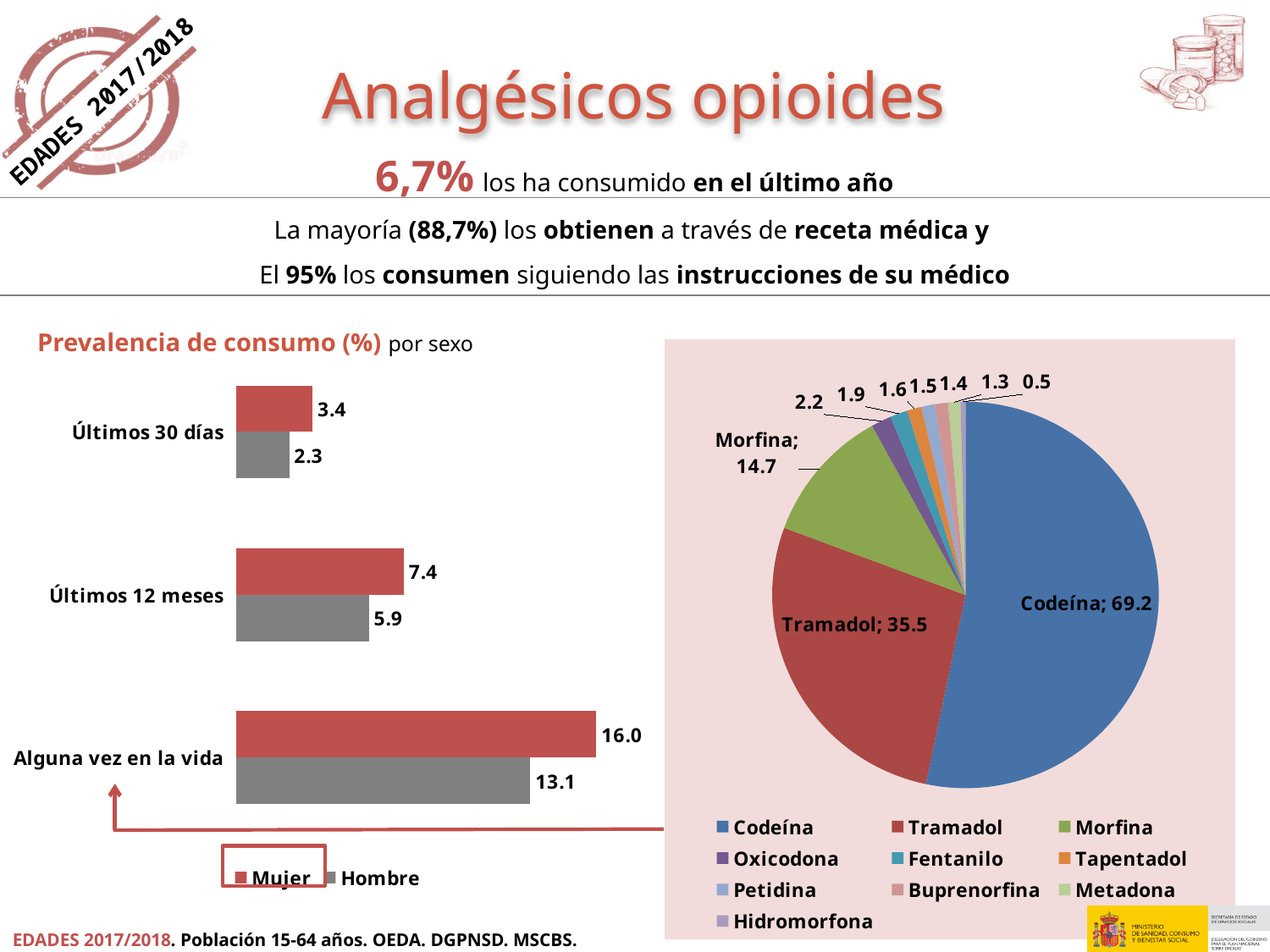
In the pie chart on the right, what is the value for Codeína? 69.2 In the bar chart 'Prevalencia de consumo (%) por sexo', which is larger for 'Últimos 12 meses', Mujer or Hombre? Mujer In the bar chart 'Prevalencia de consumo (%) por sexo', what is the value for Mujer in 'Alguna vez en la vida'? 16.0 In the bar chart 'Prevalencia de consumo (%) por sexo', how many categories are shown? 3 In the pie chart on the right, which category has the largest slice? Codeína In the bar chart 'Prevalencia de consumo (%) por sexo', what is the value for Hombre in 'Últimos 12 meses'? 5.9 In the pie chart on the right, how many entries does the legend list? 10 In the pie chart on the right, what is the value for Tramadol? 35.5 In the bar chart 'Prevalencia de consumo (%) por sexo', what is the value for Hombre in 'Últimos 30 días'? 2.3 In the bar chart 'Prevalencia de consumo (%) por sexo', how many series does the legend list? 2 In the bar chart 'Prevalencia de consumo (%) por sexo', what is the difference between Mujer and Hombre for 'Alguna vez en la vida'? 2.9 What kind of chart is the chart on the right side of the slide? Pie chart